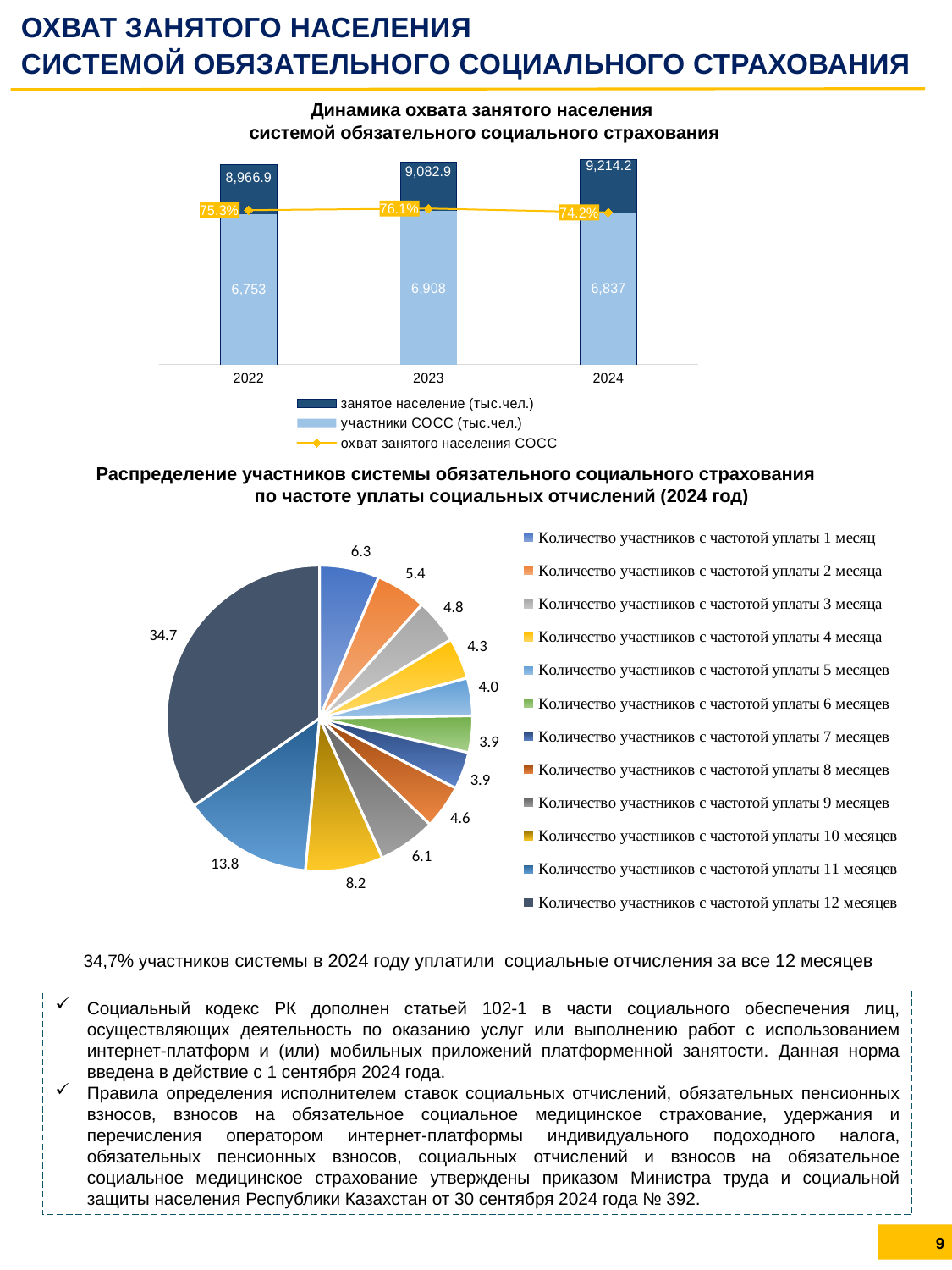
In the top chart 'Динамика охвата занятого населения', how many series does the legend list? 3 In the top chart 'Динамика охвата занятого населения', which year has the highest coverage rate ('охват занятого населения СОСС')? 2023 In the bottom pie chart, what is the value for 'Количество участников с частотой уплаты 12 месяцев'? 34.7 What kind of chart is the bottom chart 'Распределение участников системы обязательного социального страхования по частоте уплаты социальных отчислений (2024 год)'? pie chart In the top chart 'Динамика охвата занятого населения', does the value of 'занятое население (тыс.чел.)' rise or fall from 2022 to 2024? rise In the bottom pie chart, which is larger: the value for 'частотой уплаты 1 месяц' or 'частотой уплаты 10 месяцев'? частотой уплаты 10 месяцев In the top chart 'Динамика охвата занятого населения', what is the coverage rate ('охват занятого населения СОСС') for 2022? 75.3% In the bottom pie chart, how many slices (categories) are there? 12 In the top chart 'Динамика охвата занятого населения', what is the value of 'занятое население (тыс.чел.)' for 2024? 9,214.2 In the top chart 'Динамика охвата занятого населения', what is the difference between 'занятое население' and 'участники СОСС' in 2022? 2,213.9 In the bottom pie chart, what is the value for 'Количество участников с частотой уплаты 11 месяцев'? 13.8 In the top chart 'Динамика охвата занятого населения', what is the value of 'участники СОСС (тыс.чел.)' for 2023? 6,908